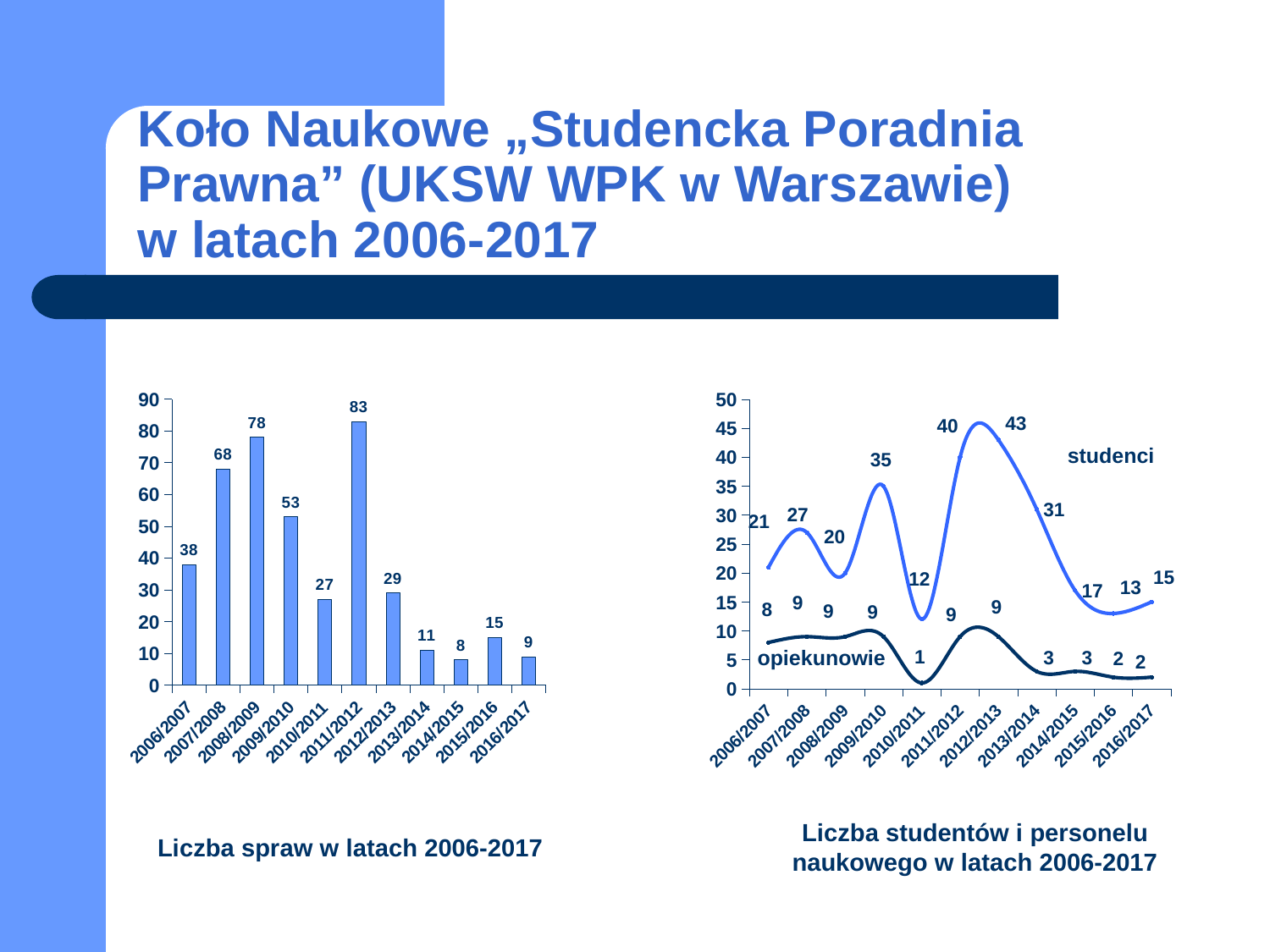
In the chart 'Liczba spraw w latach 2006-2017', how many years are shown on the x axis? 11 In the chart 'Liczba spraw w latach 2006-2017', what is the value for 2008/2009? 78 In the chart 'Liczba studentów i personelu naukowego w latach 2006-2017', what is the value for opiekunowie in 2010/2011? 1 What kind of chart is 'Liczba spraw w latach 2006-2017'? bar chart In the chart 'Liczba studentów i personelu naukowego w latach 2006-2017', which is larger: studenci in 2009/2010 or studenci in 2013/2014? studenci in 2009/2010 In the chart 'Liczba studentów i personelu naukowego w latach 2006-2017', which year has the lowest value for studenci? 2010/2011 In the chart 'Liczba spraw w latach 2006-2017', what is the difference between the values for 2011/2012 and 2012/2013? 54 In the chart 'Liczba spraw w latach 2006-2017', which year has the lowest value? 2014/2015 In the chart 'Liczba studentów i personelu naukowego w latach 2006-2017', what is the difference between studenci and opiekunowie in 2011/2012? 31 In the chart 'Liczba studentów i personelu naukowego w latach 2006-2017', what is the value for studenci in 2012/2013? 43 In the chart 'Liczba spraw w latach 2006-2017', which year has the highest value? 2011/2012 What kind of chart is 'Liczba studentów i personelu naukowego w latach 2006-2017'? line chart